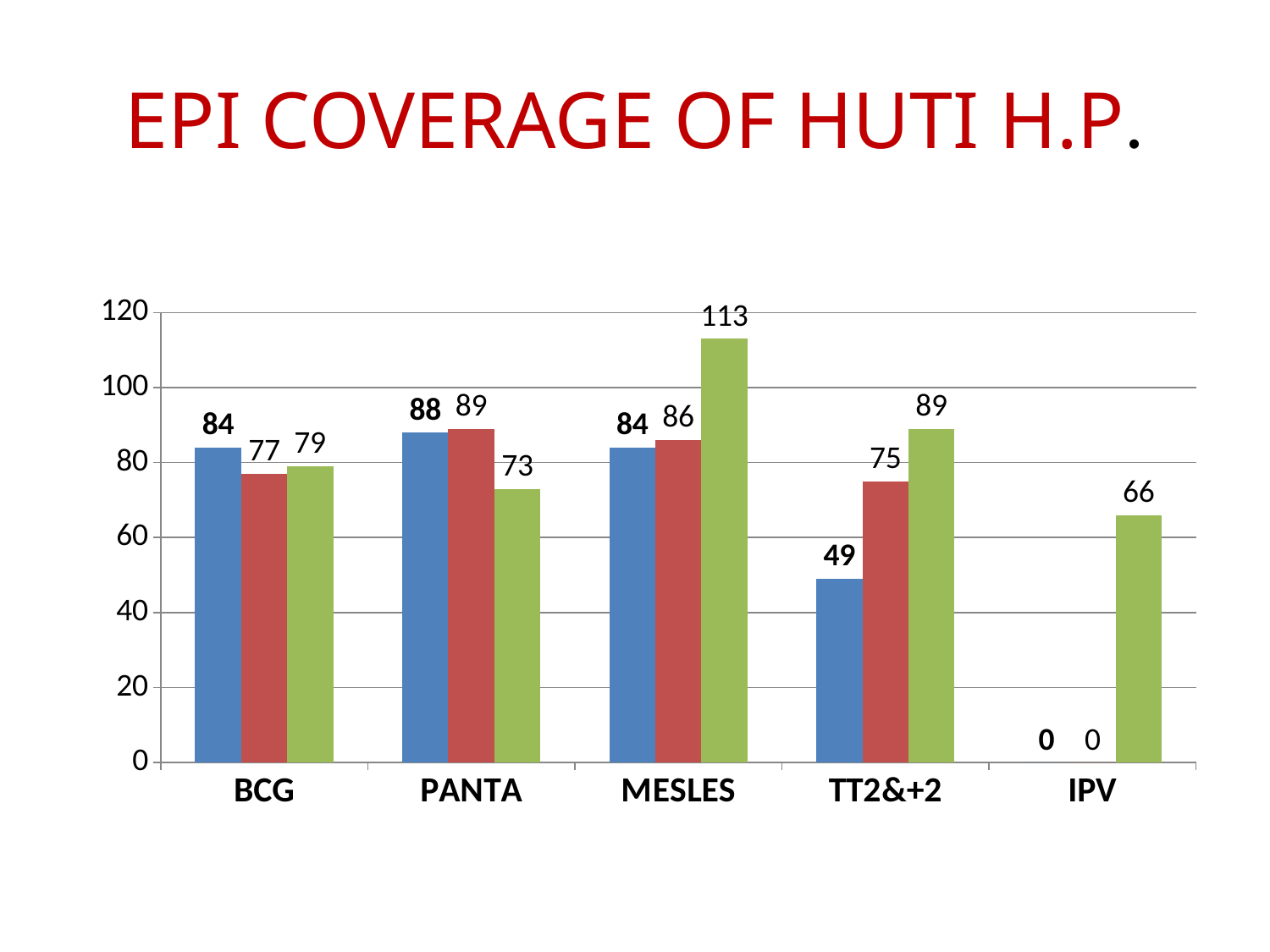
What is the value of the green bar for MESLES? 113 Which is larger for PANTA, the red bar or the green bar? the red bar Which category has the highest green bar? MESLES What is the value of the red bar for TT2&+2? 75 Which category has the lowest blue bar? IPV What is the title of the slide? EPI COVERAGE OF HUTI H.P. What is the difference between the green bar and the blue bar for MESLES? 29 What is the value of the blue bar for BCG? 84 How many categories are shown on the x axis? 5 What is the value of the green bar for IPV? 66 What kind of chart is shown on the slide? bar chart Is the value of the blue bar for TT2&+2 greater or less than 60? less